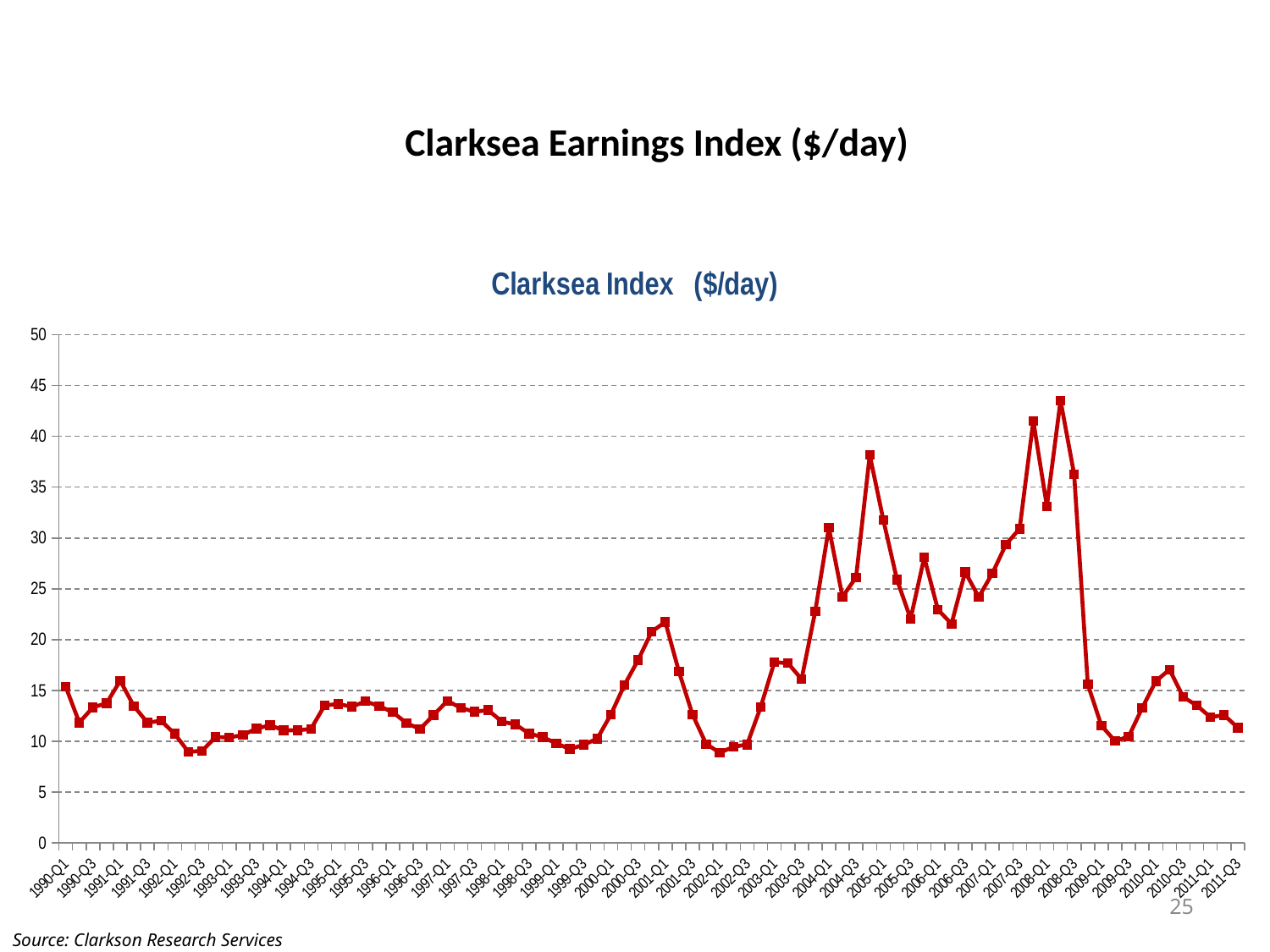
What kind of chart is shown on the slide? line chart At which quarter does the Clarksea Index reach its highest value? 2008-Q2 Is the value for 2002-Q1 greater or less than 10? less Is the value for 2011-Q3 greater or less than 15? less What is the title shown above the chart plot area? Clarksea Index ($/day) Is the value for 2009-Q3 greater or less than 15? less Which is larger, the value for 2008-Q3 or the value for 2005-Q1? 2008-Q3 Which is larger, the value for 2001-Q1 or the value for 1995-Q1? 2001-Q1 Does the Clarksea Index rise or fall between 2008-Q3 and 2009-Q1? fall